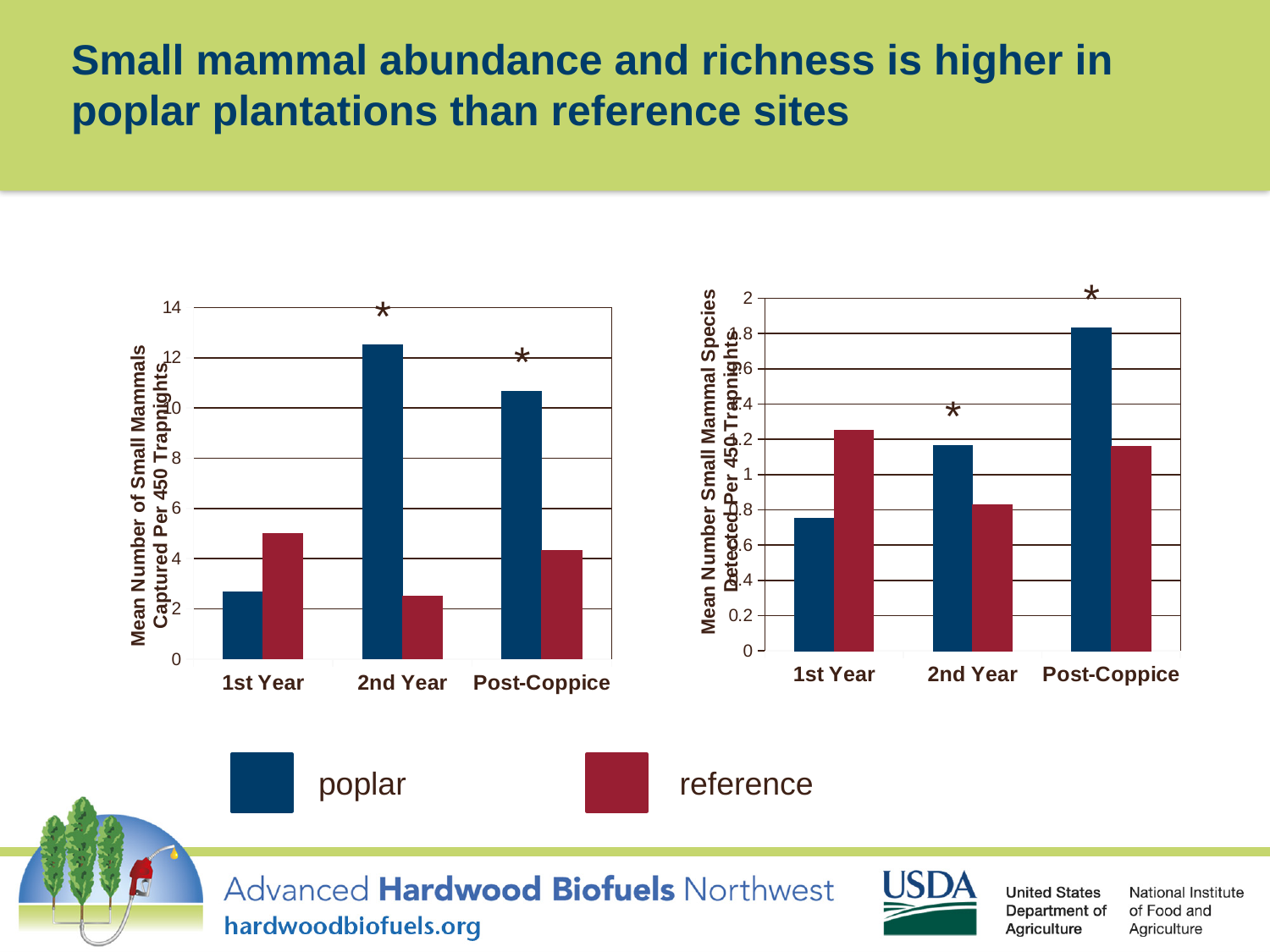
In the left chart (Mean Number of Small Mammals Captured), is the poplar value for 2nd Year greater or less than 12? greater In the left chart (Mean Number of Small Mammals Captured), which category has the lowest poplar bar? 1st Year In the left chart (Mean Number of Small Mammals Captured), which is larger for 1st Year, poplar or reference? reference What kind of chart is the left chart (Mean Number of Small Mammals Captured Per 450 Trapnights)? bar chart How many series does the shared legend below the charts list? 2 In the left chart (Mean Number of Small Mammals Captured), which category has the highest poplar bar? 2nd Year In the right chart (Mean Number Small Mammal Species Detected), do the poplar values rise or fall from 1st Year to Post-Coppice? rise In the right chart (Mean Number Small Mammal Species Detected), which is larger for 1st Year, poplar or reference? reference What colour represents the reference series in the legend? red How many categories are shown on the x axis of the left chart (Mean Number of Small Mammals Captured)? 3 In the right chart (Mean Number Small Mammal Species Detected), which category has the highest poplar bar? Post-Coppice